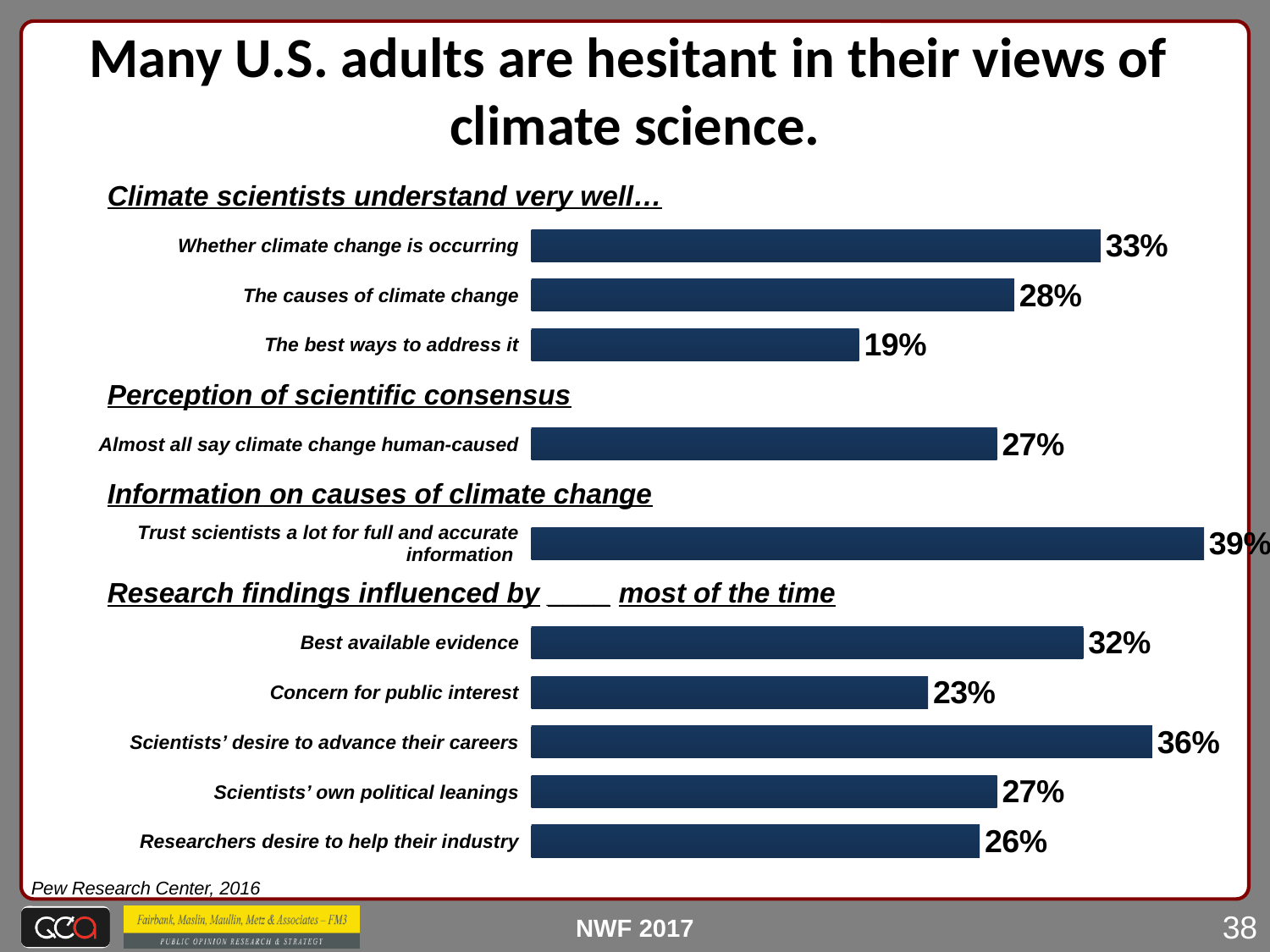
How many bars are plotted on the chart? 10 What source is cited for the data on the slide? Pew Research Center, 2016 What percentage say research findings are influenced by scientists' desire to advance their careers most of the time? 36% What is the value for 'Trust scientists a lot for full and accurate information'? 39% What percentage of U.S. adults say climate scientists understand very well whether climate change is occurring? 33% What is the difference between the values for 'Scientists' desire to advance their careers' and 'Scientists' own political leanings'? 9% What kind of chart is shown on the slide? Bar chart Which is larger: the value for 'Best available evidence' or 'Concern for public interest'? Best available evidence What is the difference between the value for 'Whether climate change is occurring' and 'The best ways to address it'? 14% Which bar on the chart has the lowest value? The best ways to address it Which bar on the chart has the highest value? Trust scientists a lot for full and accurate information What is the value for 'Almost all say climate change human-caused'? 27%